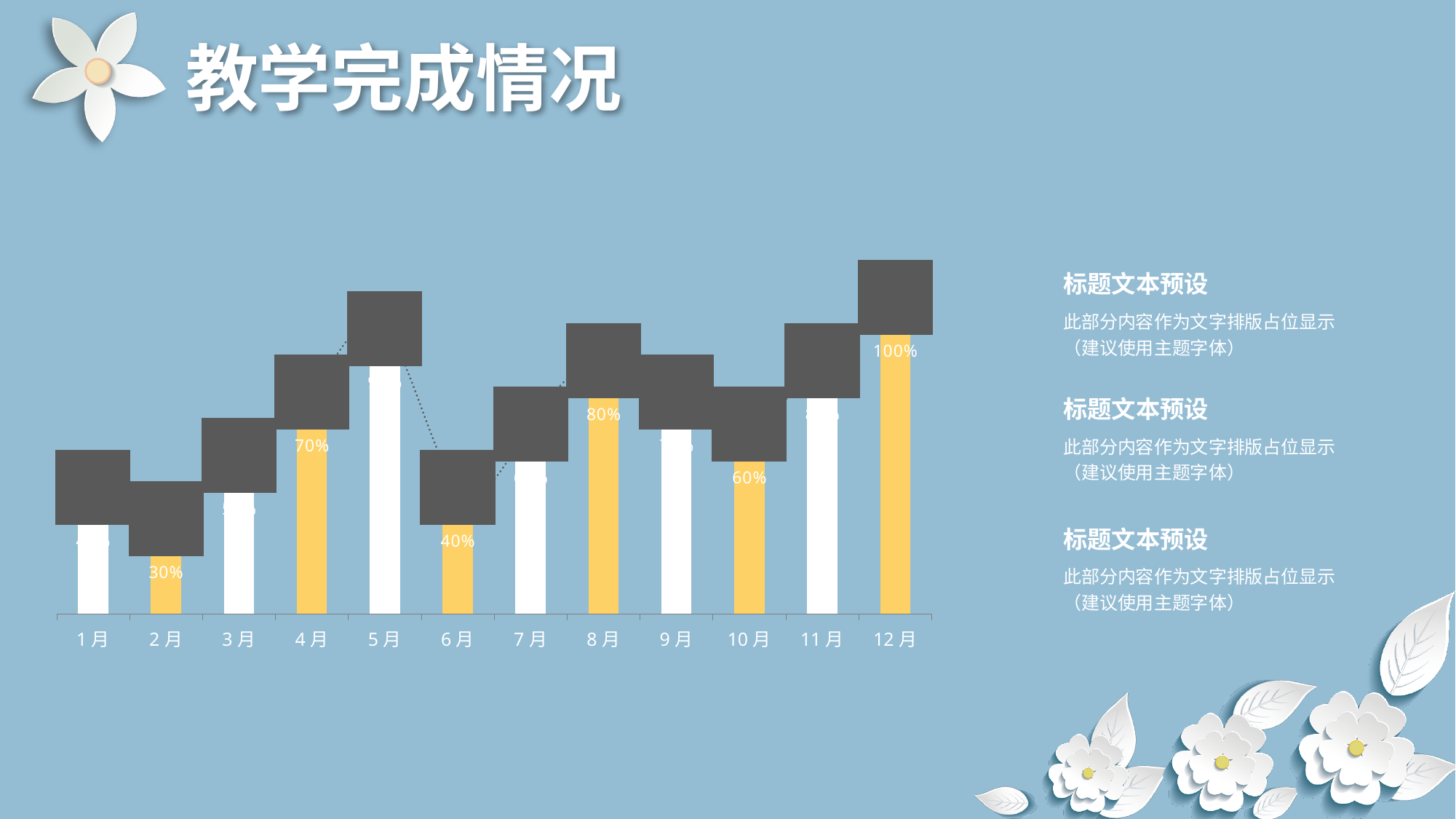
What kind of chart is shown on the slide? bar chart What is the difference between the values for 12月 and 2月? 70% What is the value for 2月? 30% What is the value for 8月? 80% How many months are shown on the x axis? 12 What is the value for 6月? 40% What is the value for 10月? 60% What is the value for 12月? 100% What is the value for 4月? 70% Which is larger, the value for 8月 or the value for 10月? 8月 Which month has the lowest value? 2月 Which month has the highest value? 12月